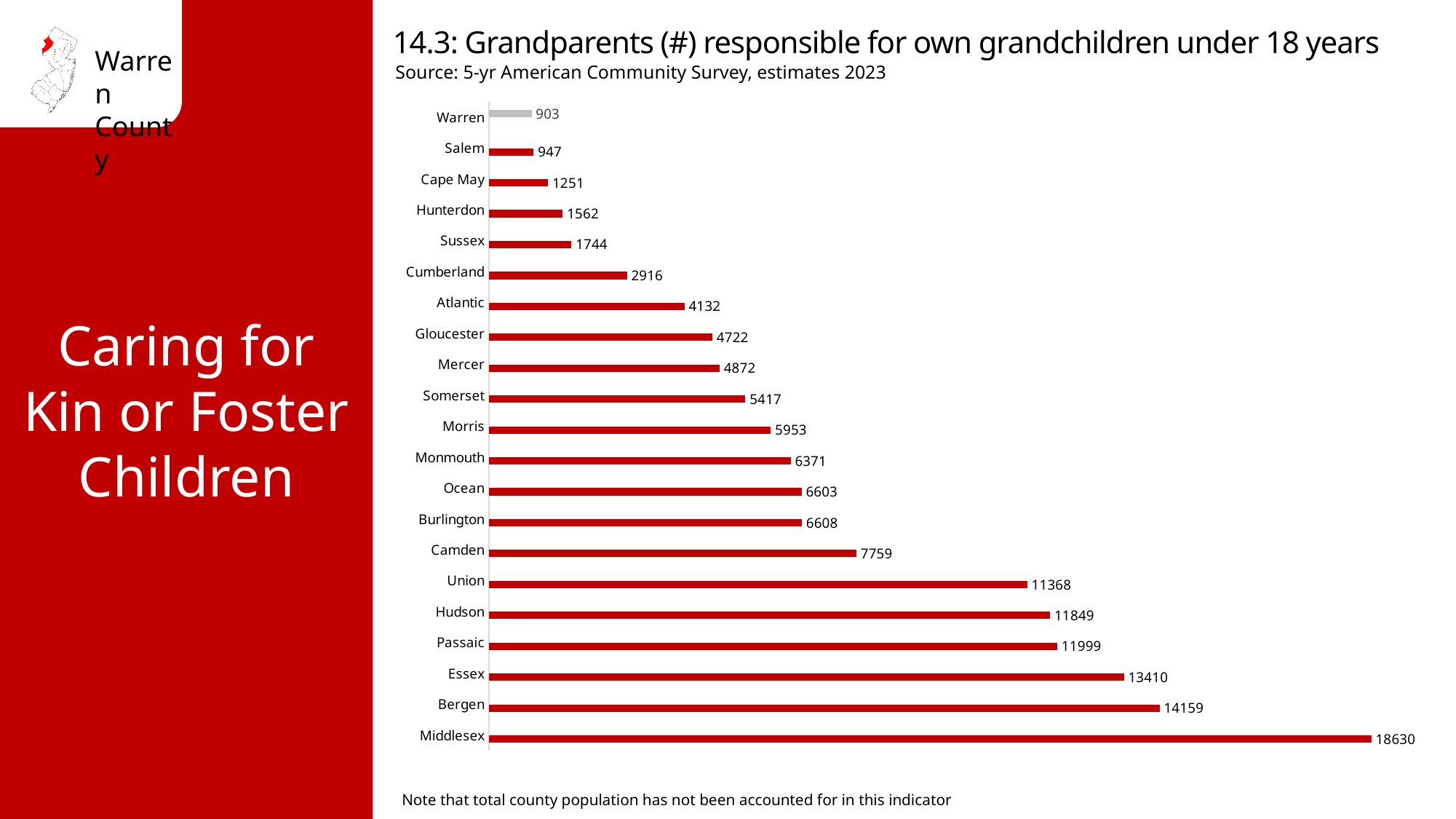
Which county has the highest number of grandparents responsible for own grandchildren? Middlesex What is the value shown for Camden? 7759 Which has a larger value, Sussex or Cumberland? Cumberland What is the difference between the values for Middlesex and Warren? 17727 Which county's bar is shown in grey rather than red? Warren What is the difference between the values for Bergen and Essex? 749 Which county has the lowest value on the chart? Warren What type of chart is shown on the slide? Bar chart How many counties are shown on the chart? 21 Which has a larger value, Union or Camden? Union What is the number of grandparents responsible for own grandchildren in Warren County? 903 What is the value shown for Middlesex? 18630